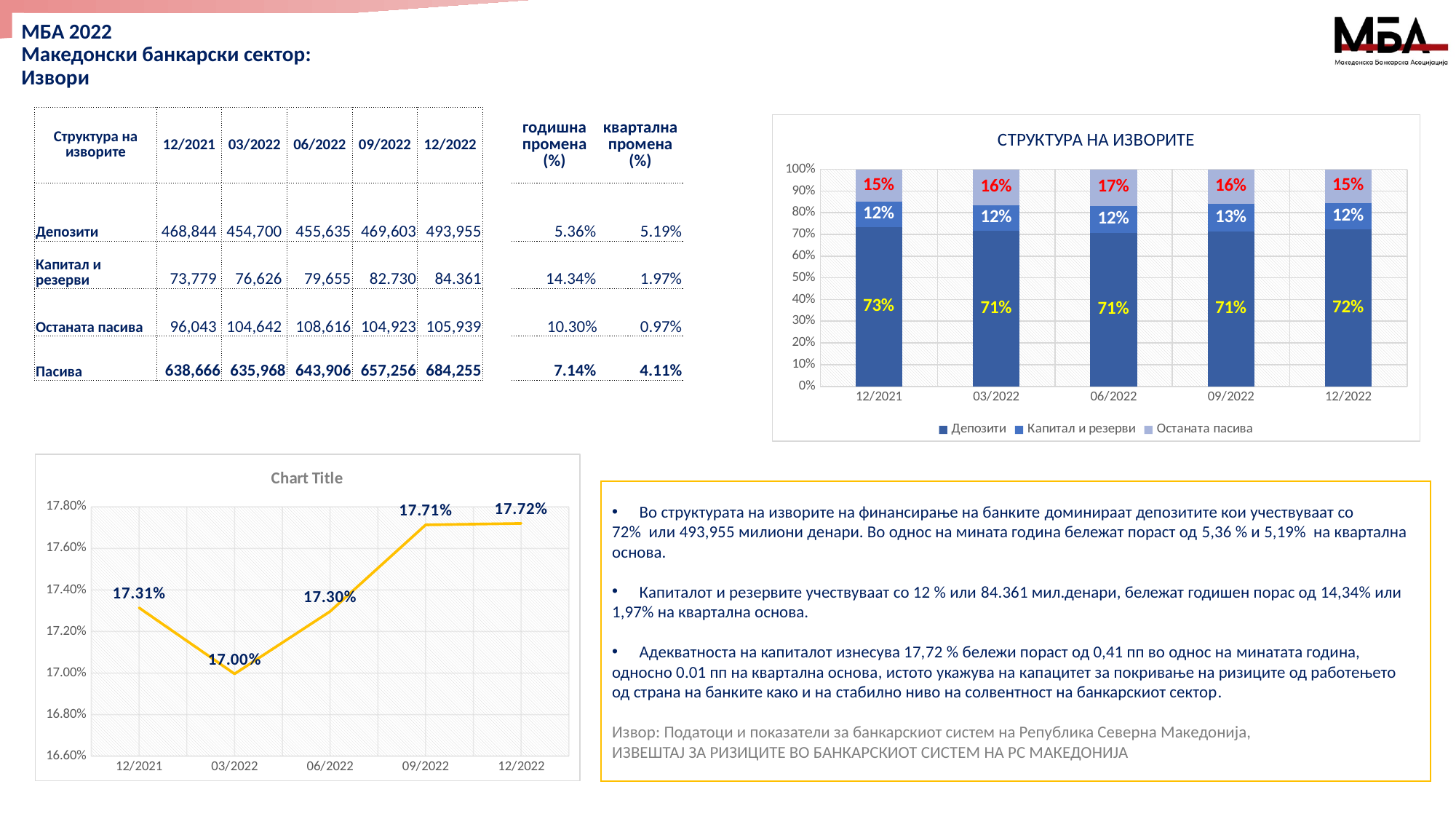
In the line chart at the bottom left titled "Chart Title", how many data points are plotted? 5 In the chart titled "СТРУКТУРА НА ИЗВОРИТЕ", how many series does the legend list? 3 In the chart titled "СТРУКТУРА НА ИЗВОРИТЕ", what kind of chart is shown? Stacked bar chart In the line chart at the bottom left titled "Chart Title", what is the value for 03/2022? 17.00% In the line chart at the bottom left titled "Chart Title", what is the value for 12/2022? 17.72% In the line chart at the bottom left titled "Chart Title", what is the difference between the values for 09/2022 and 06/2022? 0.41% In the chart titled "СТРУКТУРА НА ИЗВОРИТЕ", in which period is the Депозити share highest? 12/2021 In the line chart at the bottom left titled "Chart Title", which period has the lowest value? 03/2022 In the chart titled "СТРУКТУРА НА ИЗВОРИТЕ", what is the share of Капитал и резерви in 09/2022? 13% In the chart titled "СТРУКТУРА НА ИЗВОРИТЕ", what is the share of Депозити in 12/2021? 73% In the chart titled "СТРУКТУРА НА ИЗВОРИТЕ", what is the difference between the Депозити share and the Останата пасива share in 12/2022? 57% In the chart titled "СТРУКТУРА НА ИЗВОРИТЕ", what is the share of Останата пасива in 06/2022? 17%